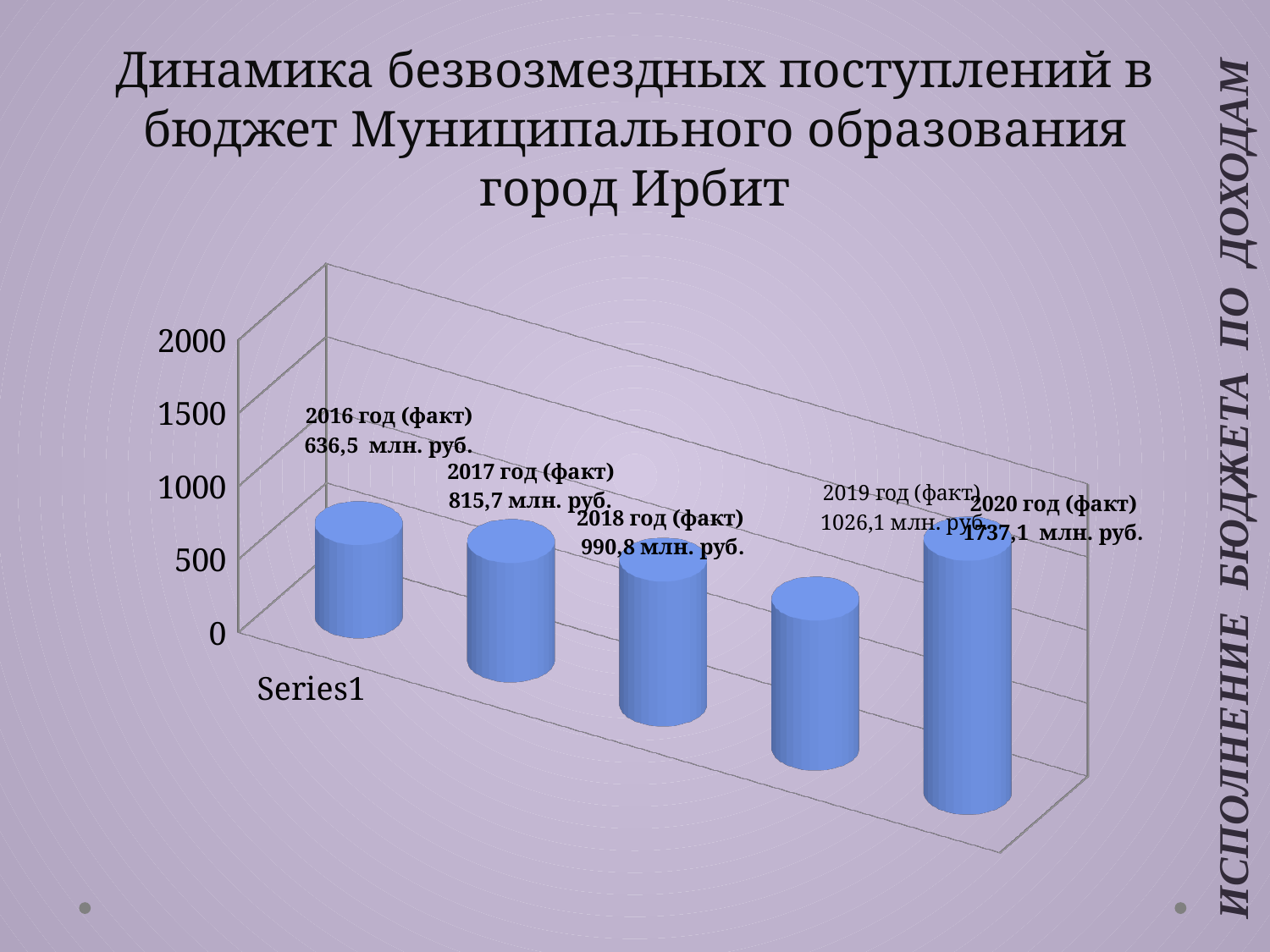
What is the value for 2018 год (факт)? 990,8 млн. руб. What is the value for 2020 год (факт)? 1737,1 млн. руб. Which year has the highest value? 2020 год (факт) What is the value for 2016 год (факт)? 636,5 млн. руб. Do the values rise or fall from 2016 to 2020? Rise How many bars are plotted on the chart? 5 What is the difference between the values for 2017 год (факт) and 2016 год (факт)? 179,2 млн. руб. What kind of chart is shown on the slide? Bar chart What is the difference between the values for 2020 год (факт) and 2016 год (факт)? 1100,6 млн. руб. Which is larger, the value for 2019 год (факт) or 2018 год (факт)? 2019 год (факт) Which year has the lowest value? 2016 год (факт) Is the value for 2020 год (факт) greater or less than 1500? greater